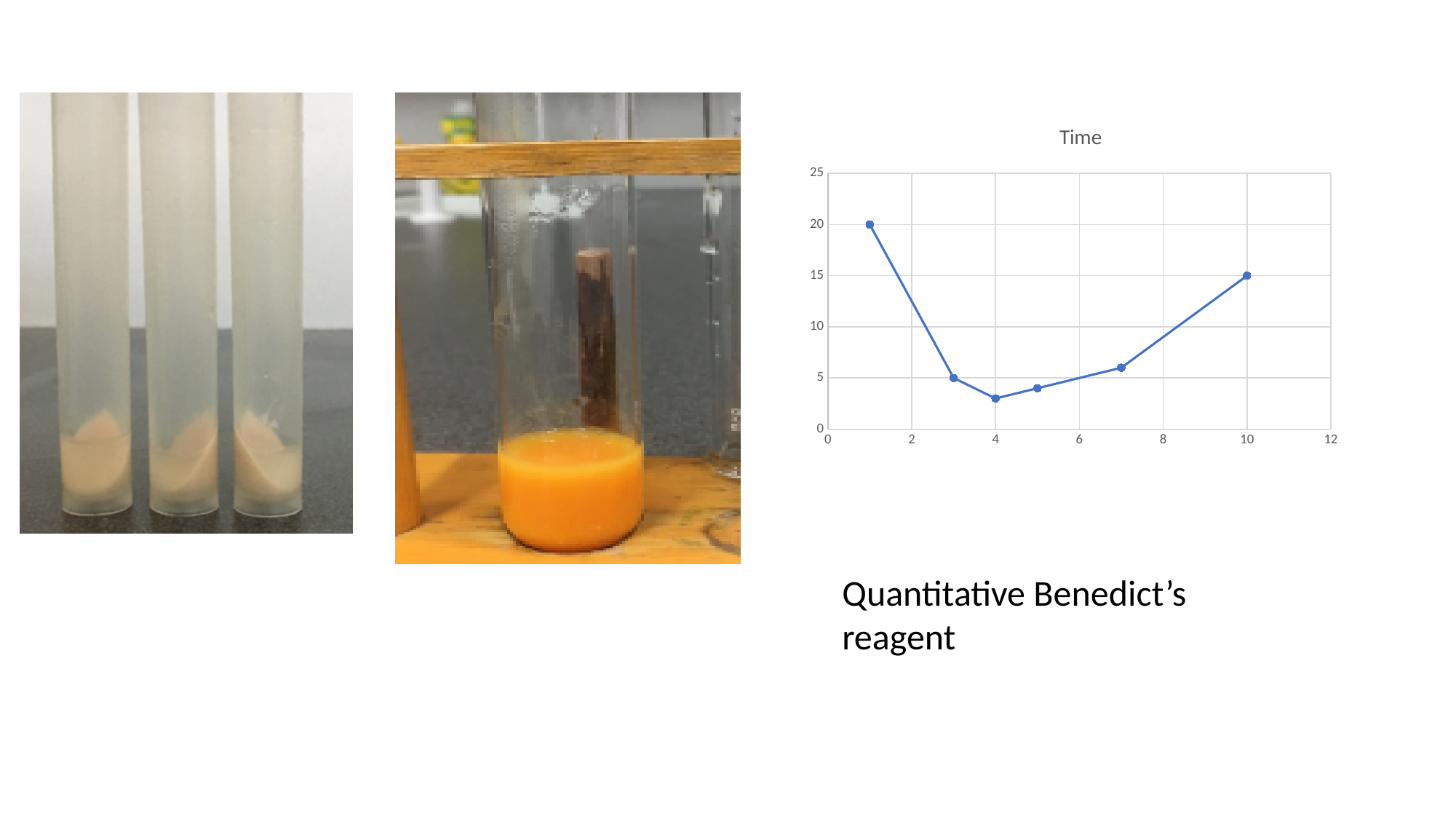
Does the line fall or rise between x = 1 and x = 4? fall What is the title of the chart? Time Is the y value at x = 7 greater or less than 10? less What kind of chart is shown on the slide? line chart Which point has the highest y value? the point at x = 1 What is the y value of the point at x = 3? 5 What is the y value of the point at x = 10? 15 What is the y value of the point at x = 1? 20 Which is larger, the y value at x = 1 or at x = 10? x = 1 Is the y value at x = 4 greater or less than 5? less What is the difference between the y values at x = 1 and x = 10? 5 How many data points are plotted on the chart? 6